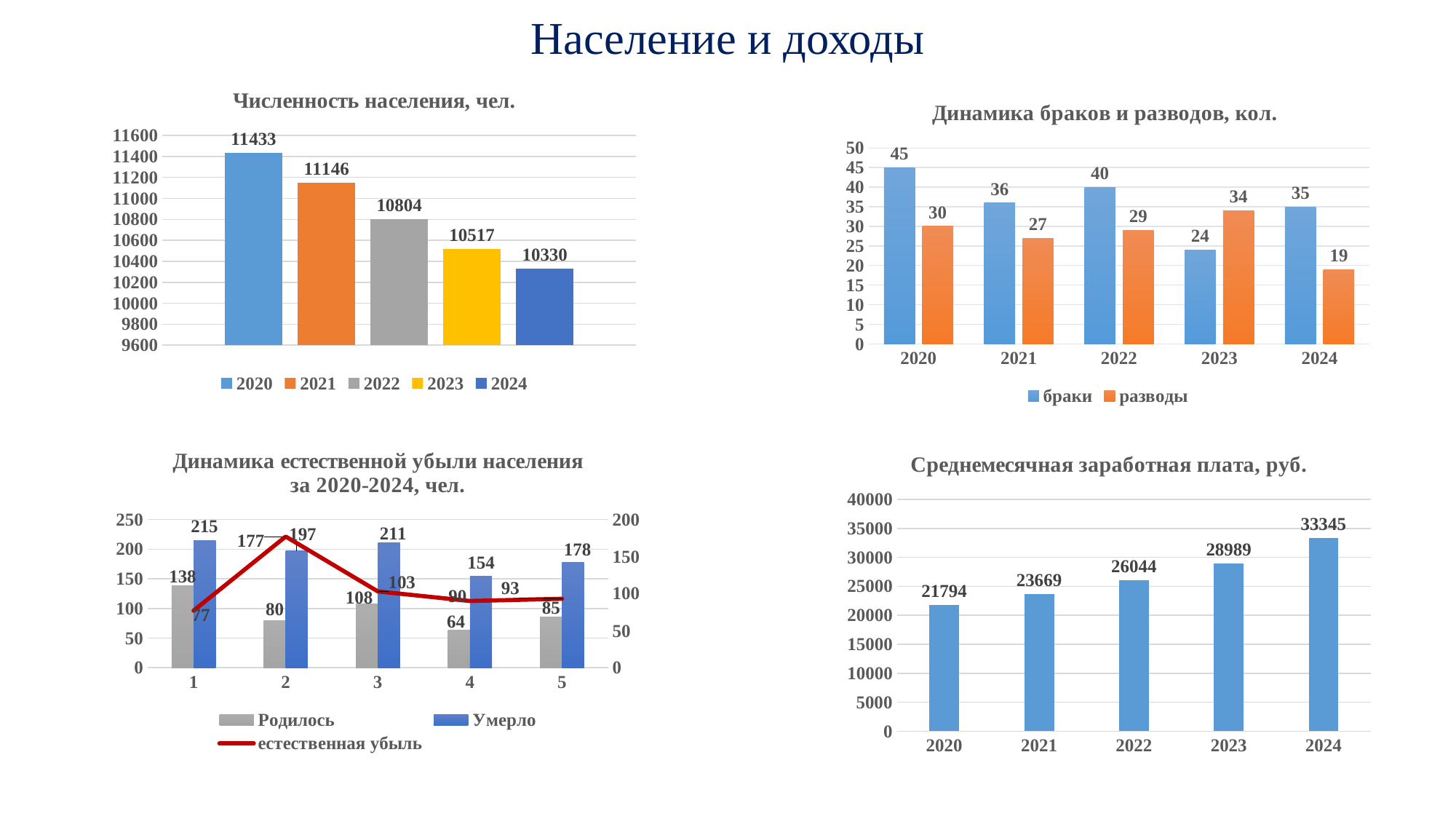
In the chart 'Динамика браков и разводов, кол.', which year has the highest value of 'браки'? 2020 In the chart 'Численность населения, чел.', which year has the lowest value? 2024 In the chart 'Динамика браков и разводов, кол.', what is the value of 'разводы' in 2023? 34 In the chart 'Динамика браков и разводов, кол.', how many series does the legend list? 2 In the chart 'Численность населения, чел.', do the values rise or fall from 2020 to 2024? fall In the chart 'Динамика естественной убыли населения за 2020-2024, чел.', what is the value of 'Умерло' for category 3? 211 In the chart 'Численность населения, чел.', what is the value for 2022? 10804 In the chart 'Динамика браков и разводов, кол.', which is larger in 2023: 'браки' or 'разводы'? разводы In the chart 'Среднемесячная заработная плата, руб.', what is the difference between the 2024 and 2023 values? 4356 In the chart 'Численность населения, чел.', what is the difference between the 2020 and 2024 values? 1103 In the chart 'Среднемесячная заработная плата, руб.', what is the value for 2021? 23669 In the chart 'Динамика естественной убыли населения за 2020-2024, чел.', what is the highest value of the 'естественная убыль' line? 177